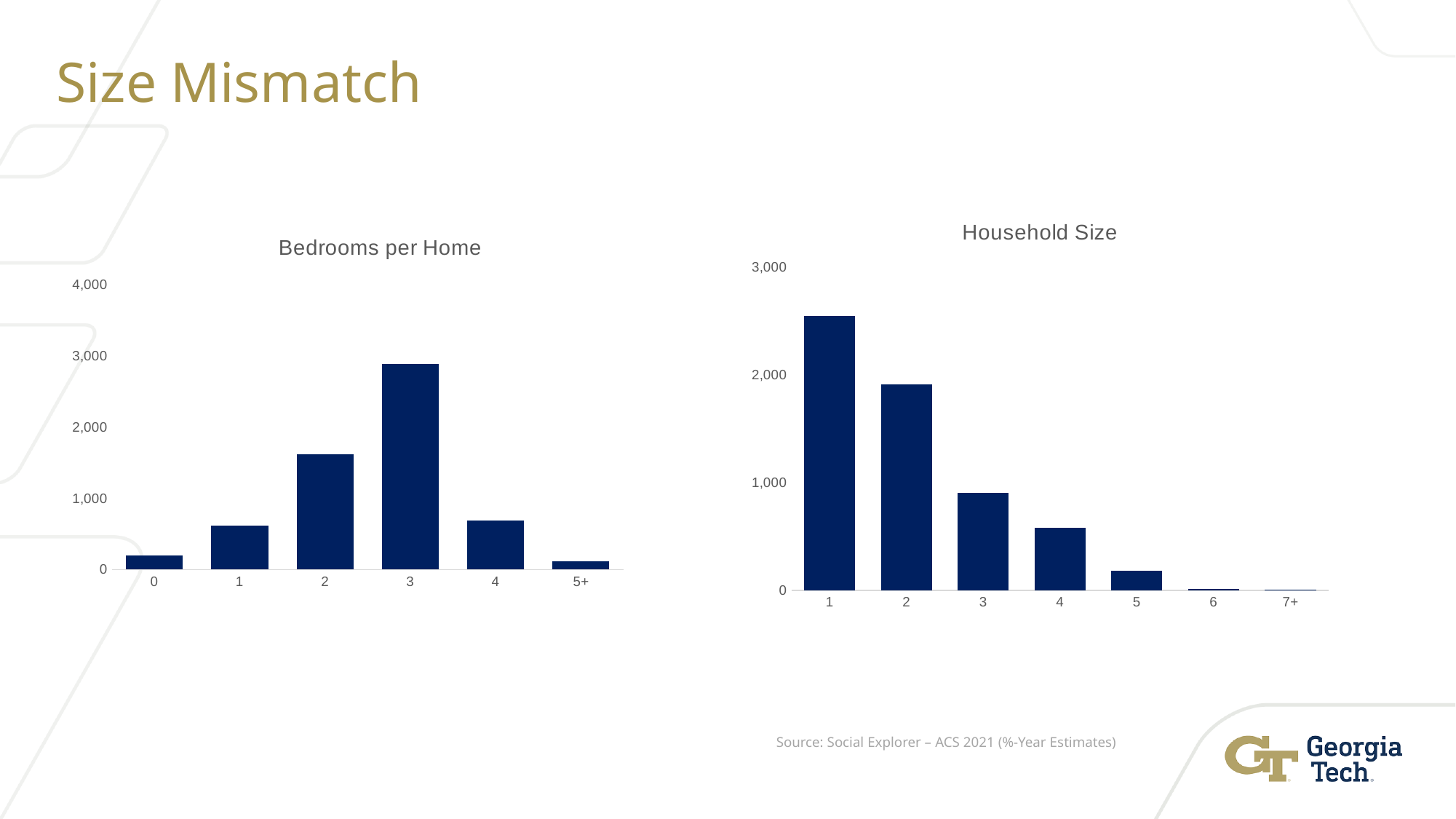
In the Bedrooms per Home chart, which category has the highest value? 3 How many categories are shown in the Household Size chart? 7 What kind of chart is the Household Size chart? bar chart In the Household Size chart, which category has the highest value? 1 In the Household Size chart, do the values rise or fall as household size increases along the x axis? fall In the Household Size chart, is the value for household size 1 greater or less than 2,000? greater In the Bedrooms per Home chart, which is larger, the value for 2 bedrooms or the value for 4 bedrooms? 2 bedrooms In the Bedrooms per Home chart, is the value for 1 bedroom greater or less than 1,000? less In the Bedrooms per Home chart, which category has the lowest value? 5+ How many categories are shown in the Bedrooms per Home chart? 6 In the Household Size chart, is the value for household size 3 greater or less than 1,000? less